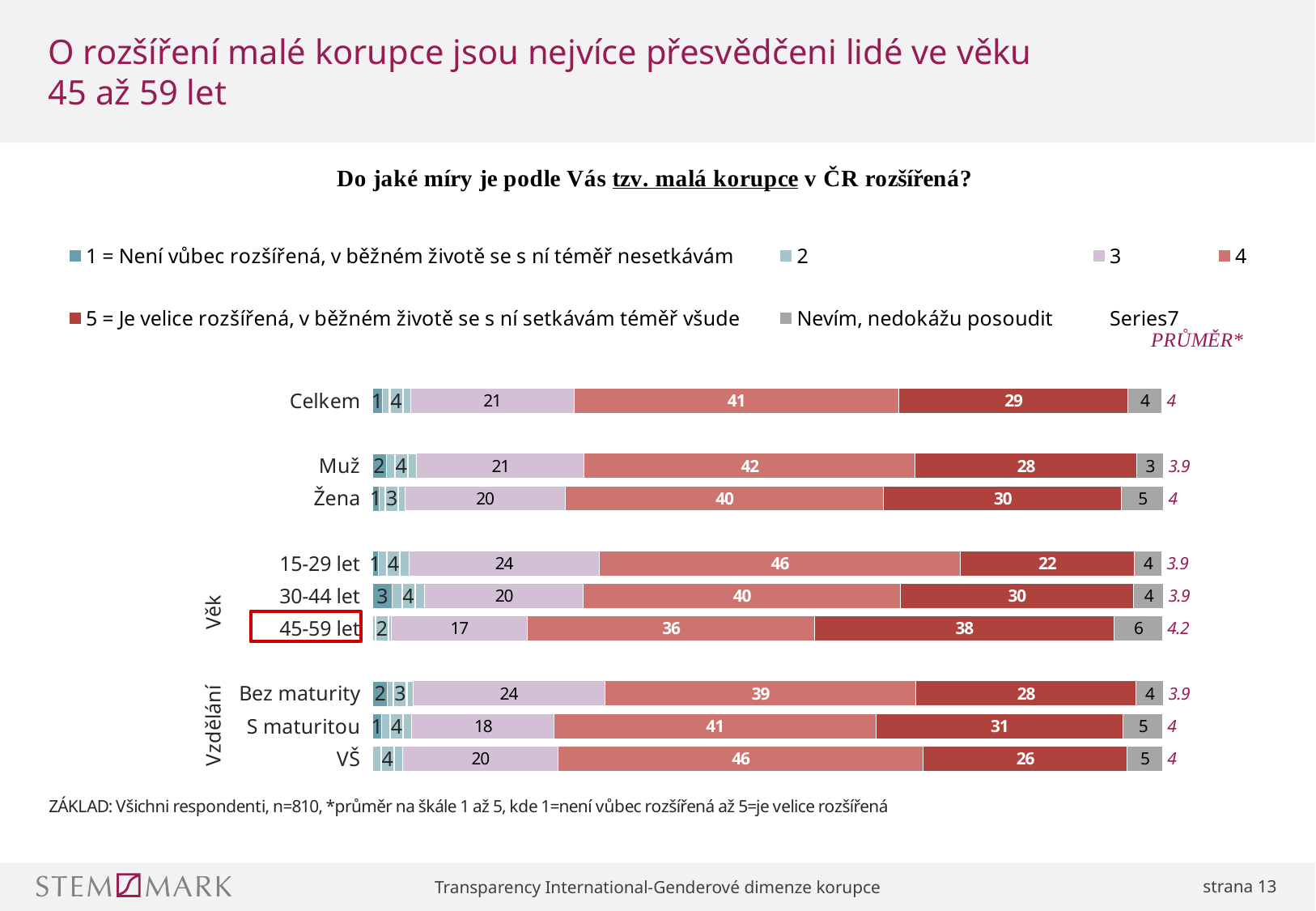
What is the difference between the values for series "4" for Muž and Žena? 2 Which has the larger value for series "4": VŠ or Bez maturity? VŠ What is the value for "5 = Je velice rozšířená, v běžném životě se s ní setkávám téměř všude" for the 45-59 let category? 38 Which category label is highlighted with a red box on the chart? 45-59 let What is the value for series "4" for the 15-29 let category? 46 What is the PRŮMĚR* value shown for the 45-59 let category? 4.2 Which category has the lowest value for "5 = Je velice rozšířená, v běžném životě se s ní setkávám téměř všude"? 15-29 let How many entries does the legend list? 7 What is the value for "Nevím, nedokážu posoudit" for the 45-59 let category? 6 What kind of chart is shown on the slide? Stacked bar chart Which category has the highest value for "5 = Je velice rozšířená, v běžném životě se s ní setkávám téměř všude"? 45-59 let How many categories are shown on the chart? 9